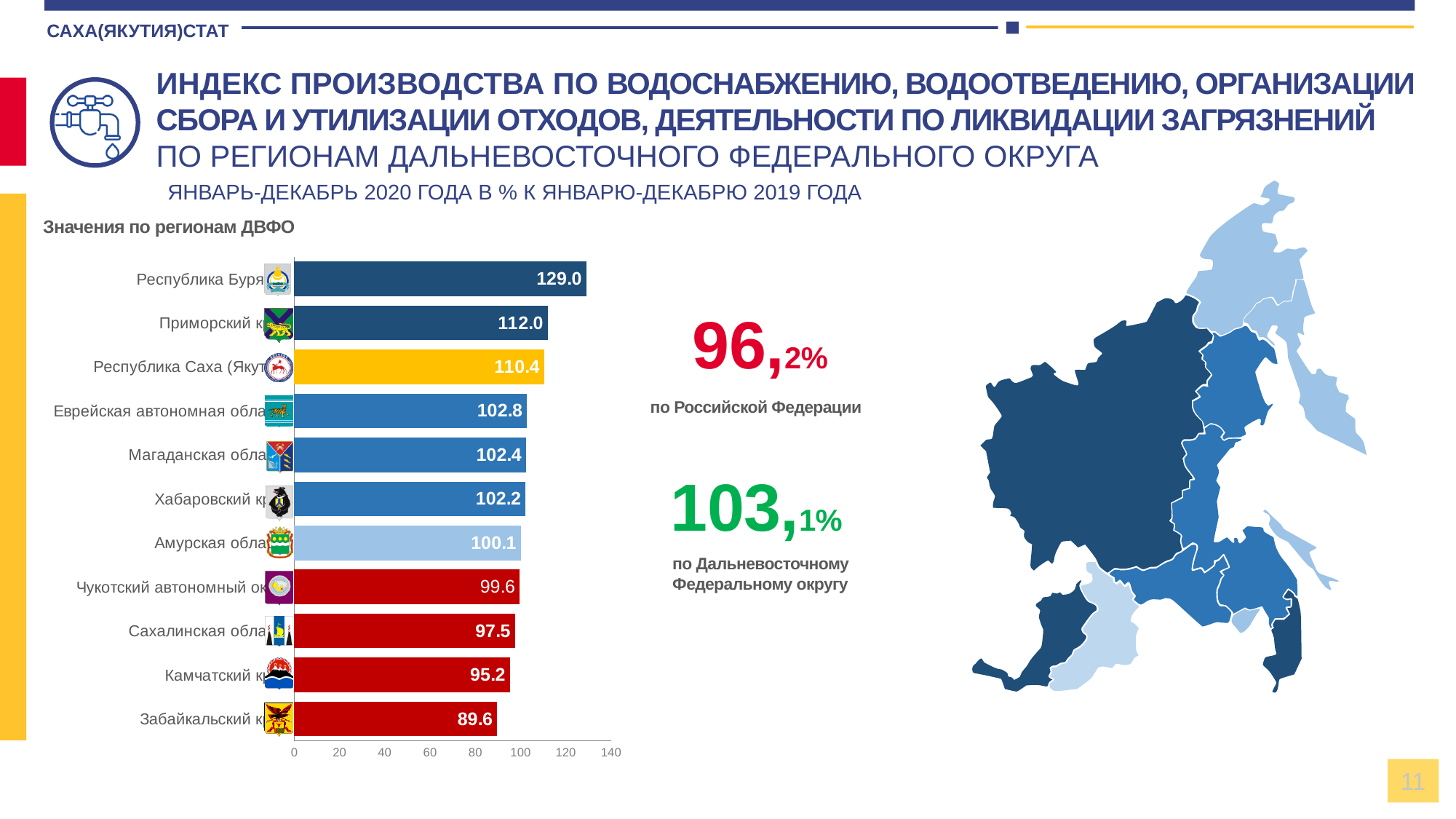
Which region's bar is coloured yellow in the chart? Республика Саха (Якутия) Is the value for Чукотский автономный округ greater or less than 100? less How many regions are shown in the bar chart? 11 Which has a larger value, Сахалинская область or Камчатский край? Сахалинская область What kind of chart is shown on the slide? bar chart Which region has the highest value in the bar chart? Республика Бурятия What is the value for Республика Саха (Якутия) in the bar chart? 110.4 What is the value for Забайкальский край in the bar chart? 89.6 What is the value shown for the Russian Federation (по Российской Федерации) on the slide? 96,2% Which region has the lowest value in the bar chart? Забайкальский край What is the difference between the values for Республика Бурятия and Приморский край? 17.0 What is the value for Магаданская область in the bar chart? 102.4